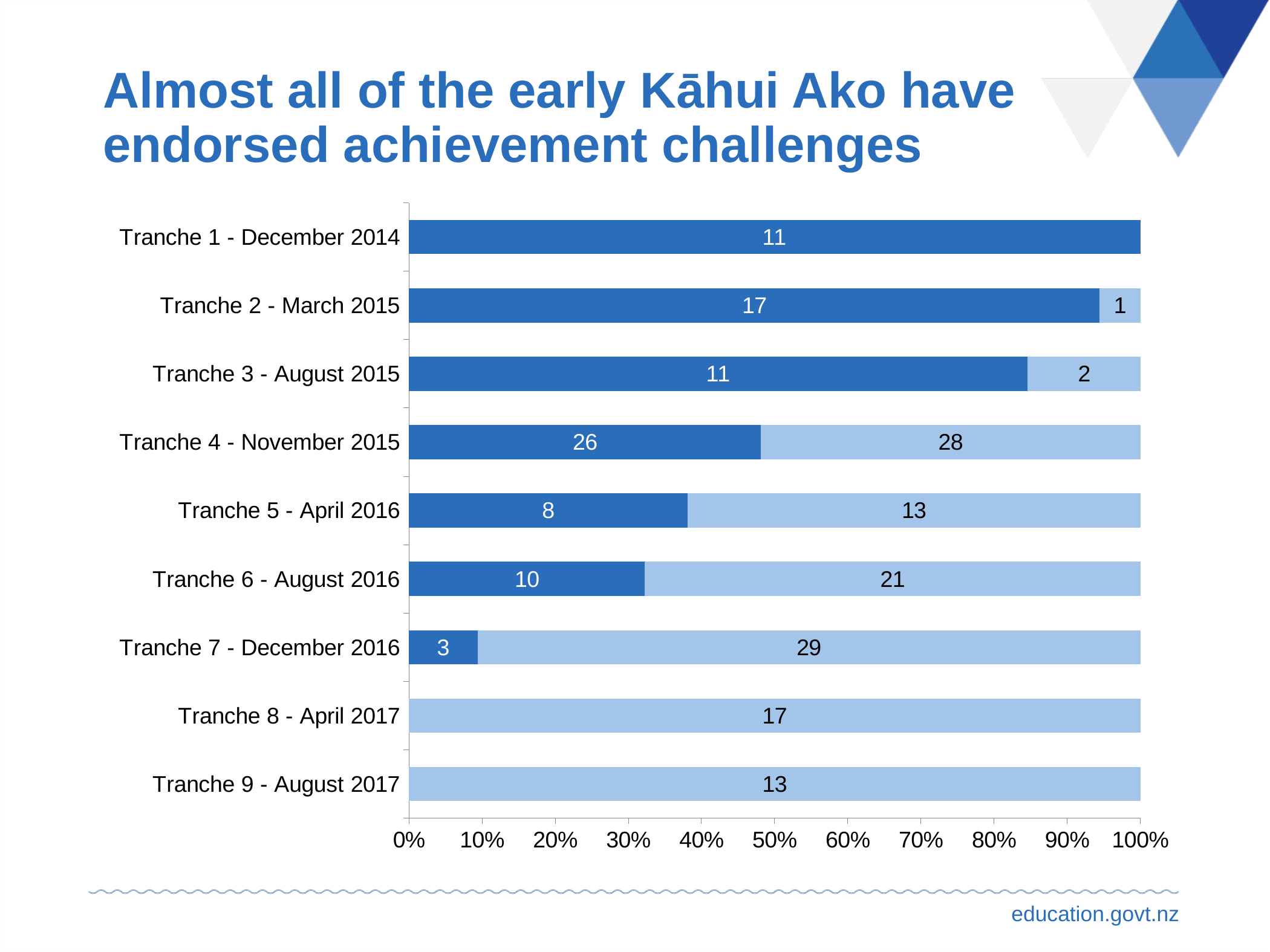
What is the difference between the light blue and dark blue segment values for Tranche 5 - April 2016? 5 What is the total of the two segments for Tranche 4 - November 2015? 54 What is the total of the two segments for Tranche 6 - August 2016? 31 How many tranches (categories) are shown on the chart? 9 What is the value shown for Tranche 8 - April 2017? 17 What kind of chart is shown on the slide? Stacked bar chart What is the value of the dark blue segment for Tranche 4 - November 2015? 26 Which tranche has the largest dark blue segment value? Tranche 4 - November 2015 What is the value of the light blue segment for Tranche 7 - December 2016? 29 Is the dark blue segment for Tranche 7 - December 2016 greater or less than 10% of the bar? less What is the value of the light blue segment for Tranche 2 - March 2015? 1 Which tranche has the largest light blue segment value? Tranche 7 - December 2016